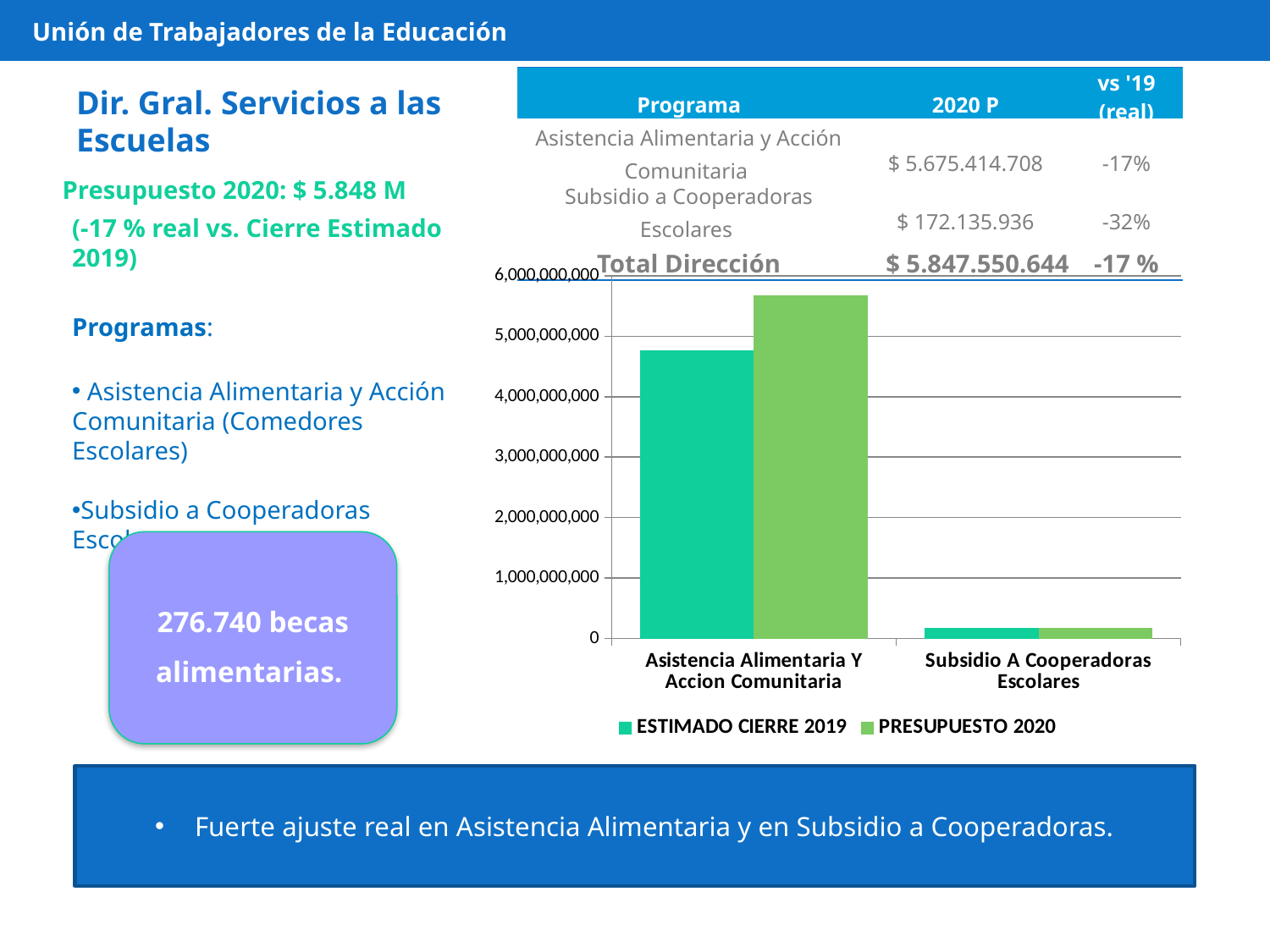
Is the PRESUPUESTO 2020 value for Subsidio A Cooperadoras Escolares greater or less than 1,000,000,000? less What kind of chart is shown on the slide? bar chart Which category has the lowest bars in the chart? Subsidio A Cooperadoras Escolares Is the ESTIMADO CIERRE 2019 value for Asistencia Alimentaria Y Accion Comunitaria greater or less than 4,000,000,000? greater What is the highest value shown on the chart's vertical axis? 6,000,000,000 How many series does the chart legend list? 2 For Asistencia Alimentaria Y Accion Comunitaria, which is larger: ESTIMADO CIERRE 2019 or PRESUPUESTO 2020? PRESUPUESTO 2020 How many categories are shown on the x axis of the chart? 2 Is the PRESUPUESTO 2020 value for Asistencia Alimentaria Y Accion Comunitaria greater or less than 5,000,000,000? greater Which category has the highest bars in the chart? Asistencia Alimentaria Y Accion Comunitaria What are the two series named in the chart legend? ESTIMADO CIERRE 2019 and PRESUPUESTO 2020